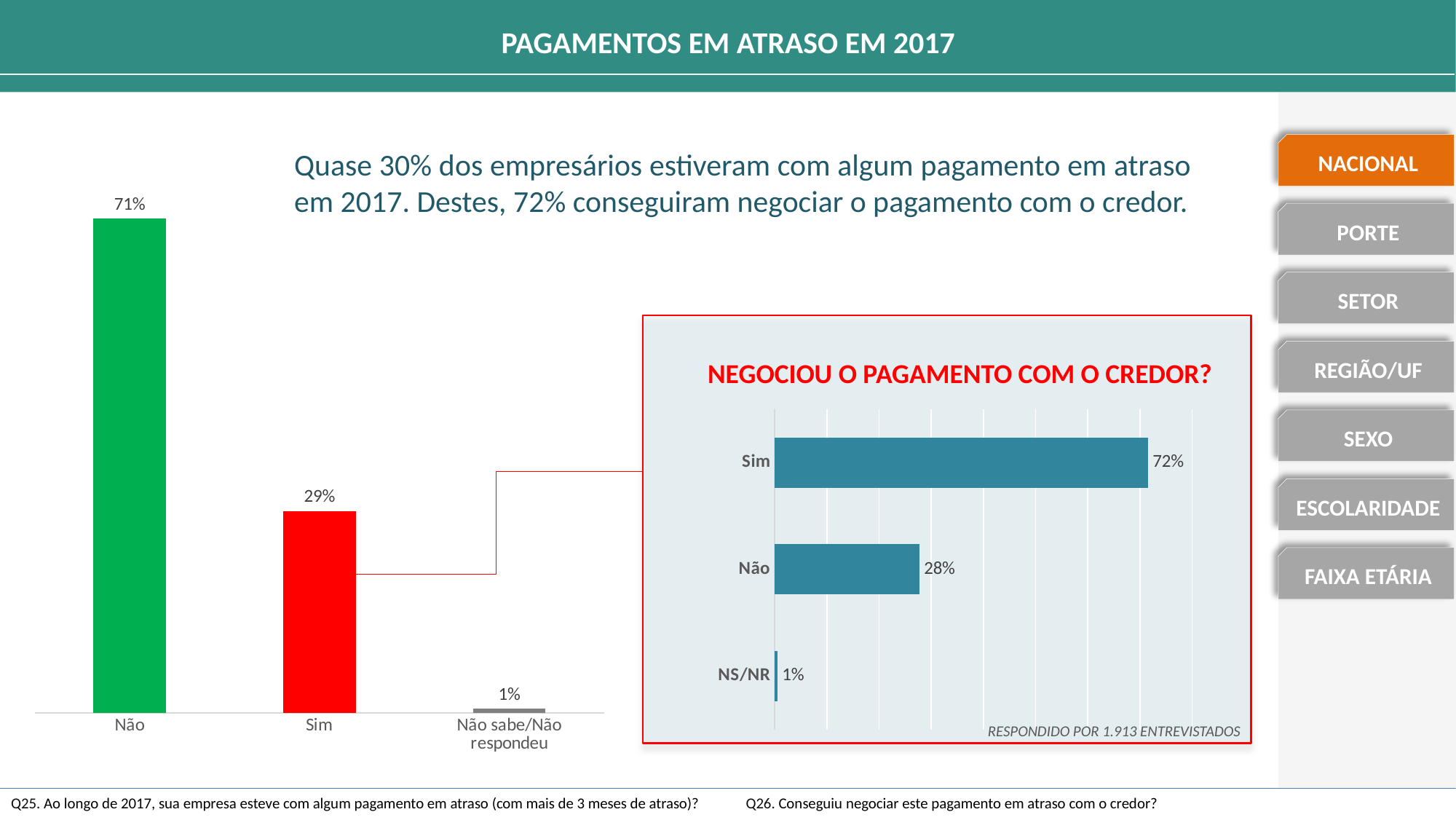
In the chart titled "NEGOCIOU O PAGAMENTO COM O CREDOR?", what is the difference between "Sim" and "Não"? 44% In the chart titled "NEGOCIOU O PAGAMENTO COM O CREDOR?", what is the value for "Sim"? 72% What kind of chart is the one titled "NEGOCIOU O PAGAMENTO COM O CREDOR?"? Bar chart In the left chart (pagamentos em atraso), which category has the highest value? Não In the chart titled "NEGOCIOU O PAGAMENTO COM O CREDOR?", what is the value for "Não"? 28% In the left chart (pagamentos em atraso), what is the difference between "Não" and "Sim"? 42% In the chart titled "NEGOCIOU O PAGAMENTO COM O CREDOR?", which category has the lowest value? NS/NR In the left chart (pagamentos em atraso), what is the value for "Sim"? 29% In the chart titled "NEGOCIOU O PAGAMENTO COM O CREDOR?", how many respondents answered, according to the note? 1.913 In the left chart (pagamentos em atraso), how many categories are shown? 3 In the left chart (pagamentos em atraso), what is the value for "Não"? 71% In the left chart (pagamentos em atraso), what is the value for "Não sabe/Não respondeu"? 1%